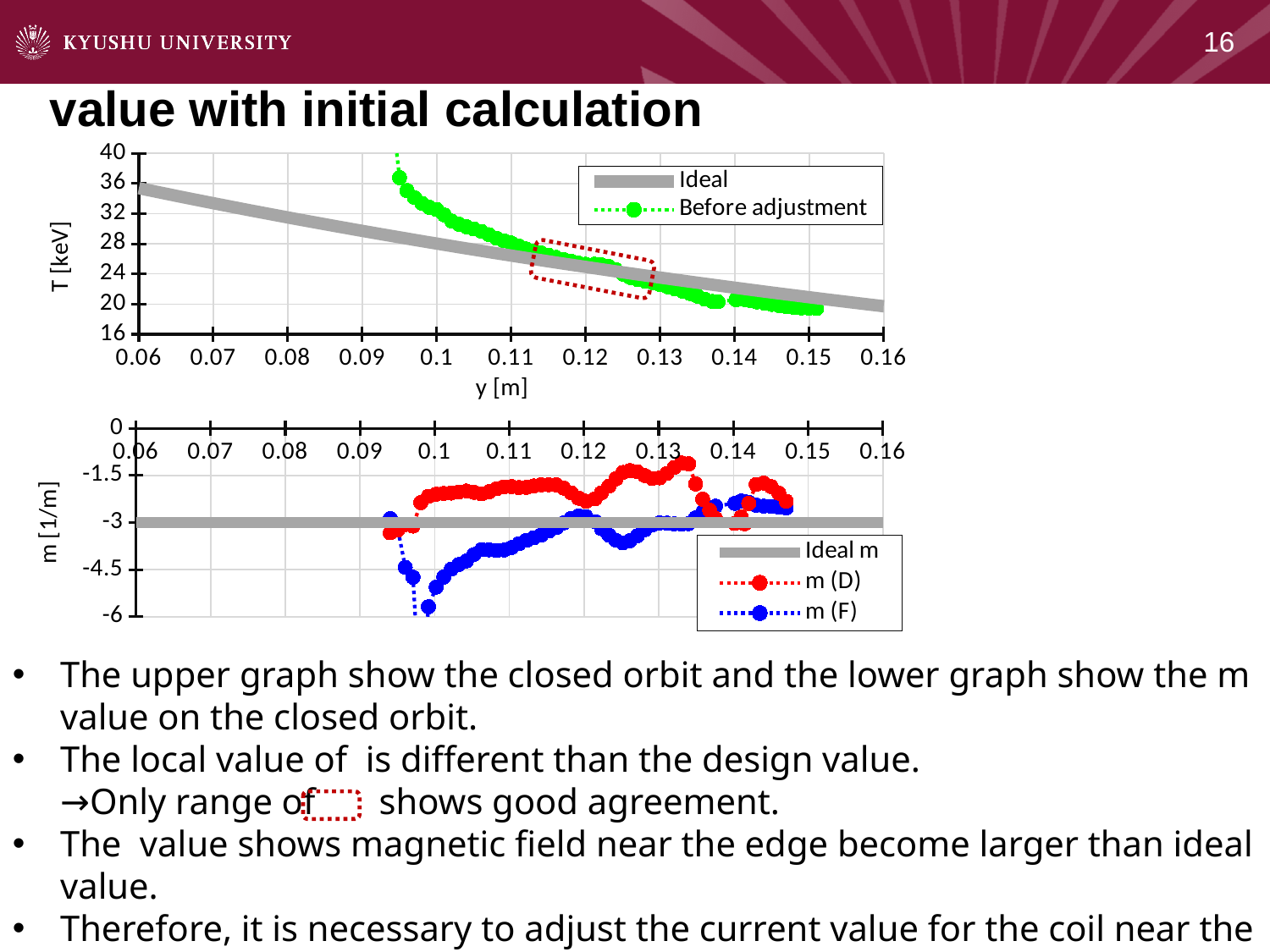
In the lower chart, what constant value does the Ideal m series take? -3 In the lower chart, is the m (D) value at y = 0.13 greater or less than -3? greater In the upper chart, does the Ideal series rise or fall as y increases? fall In the upper chart, is the Ideal value at y = 0.06 greater or less than 32? greater What is the label of the vertical axis of the upper chart? T [keV] How many series does the legend of the lower chart list? 3 How many series does the legend of the upper chart list? 2 In the lower chart, which series reaches the lowest value? m (F) In the upper chart, is the Ideal value at y = 0.16 greater or less than 24? less In the upper chart, does the Before adjustment series rise or fall as y increases? fall What are the names of the series in the lower chart's legend? Ideal m, m (D), m (F)